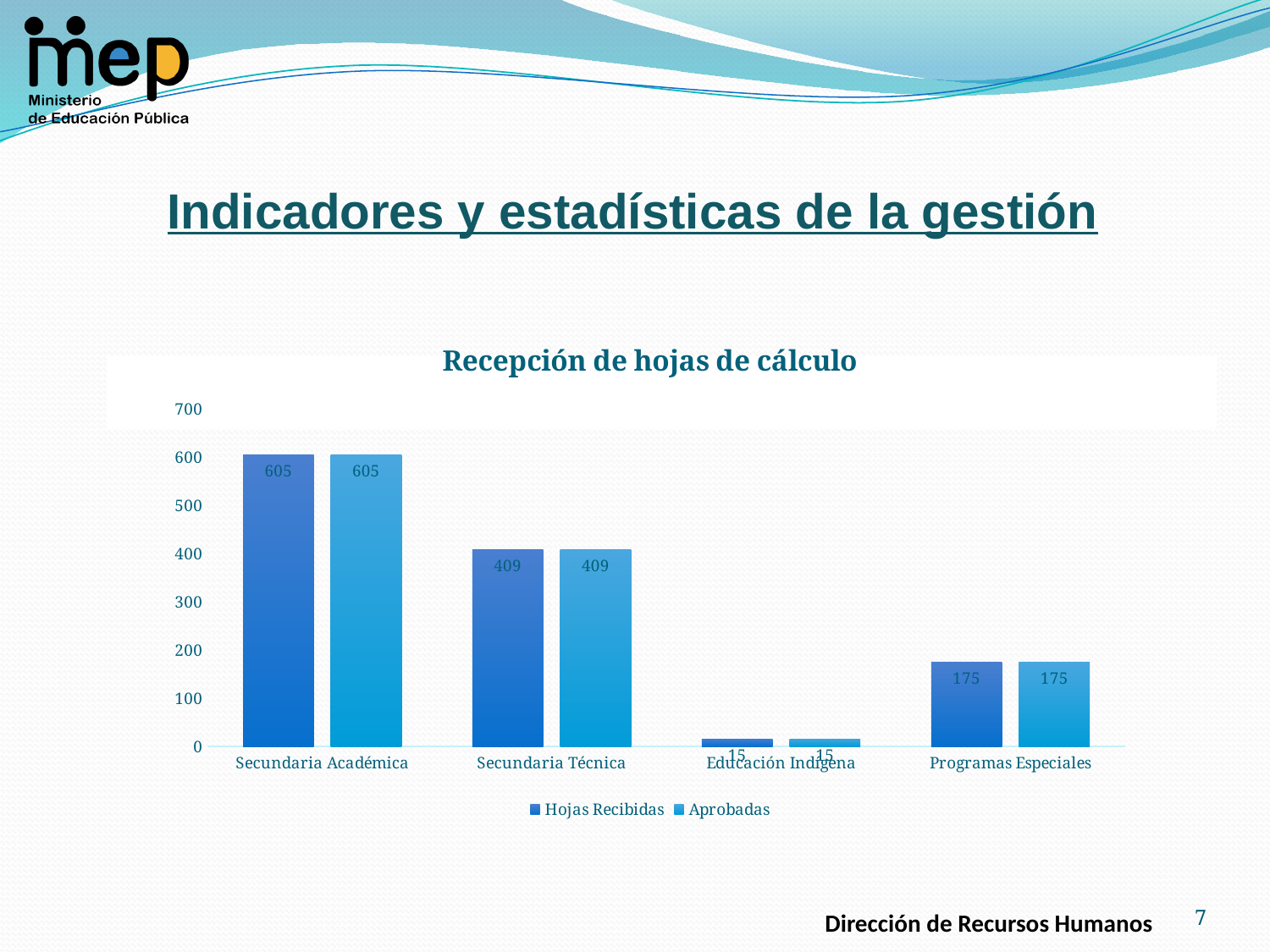
What is the value of Aprobadas for Educación Indígena? 15 What is the value of Aprobadas for Secundaria Técnica? 409 What kind of chart is shown? Bar chart What is the title of the chart? Recepción de hojas de cálculo What is the value of Hojas Recibidas for Secundaria Académica? 605 How many series does the legend list? 2 Which category has the highest value for Hojas Recibidas? Secundaria Académica What is the value of Hojas Recibidas for Programas Especiales? 175 Which category has the lowest value for Aprobadas? Educación Indígena Which is larger: Hojas Recibidas for Secundaria Técnica or for Programas Especiales? Secundaria Técnica How many categories are shown on the x axis? 4 What is the difference between Hojas Recibidas for Secundaria Académica and Secundaria Técnica? 196